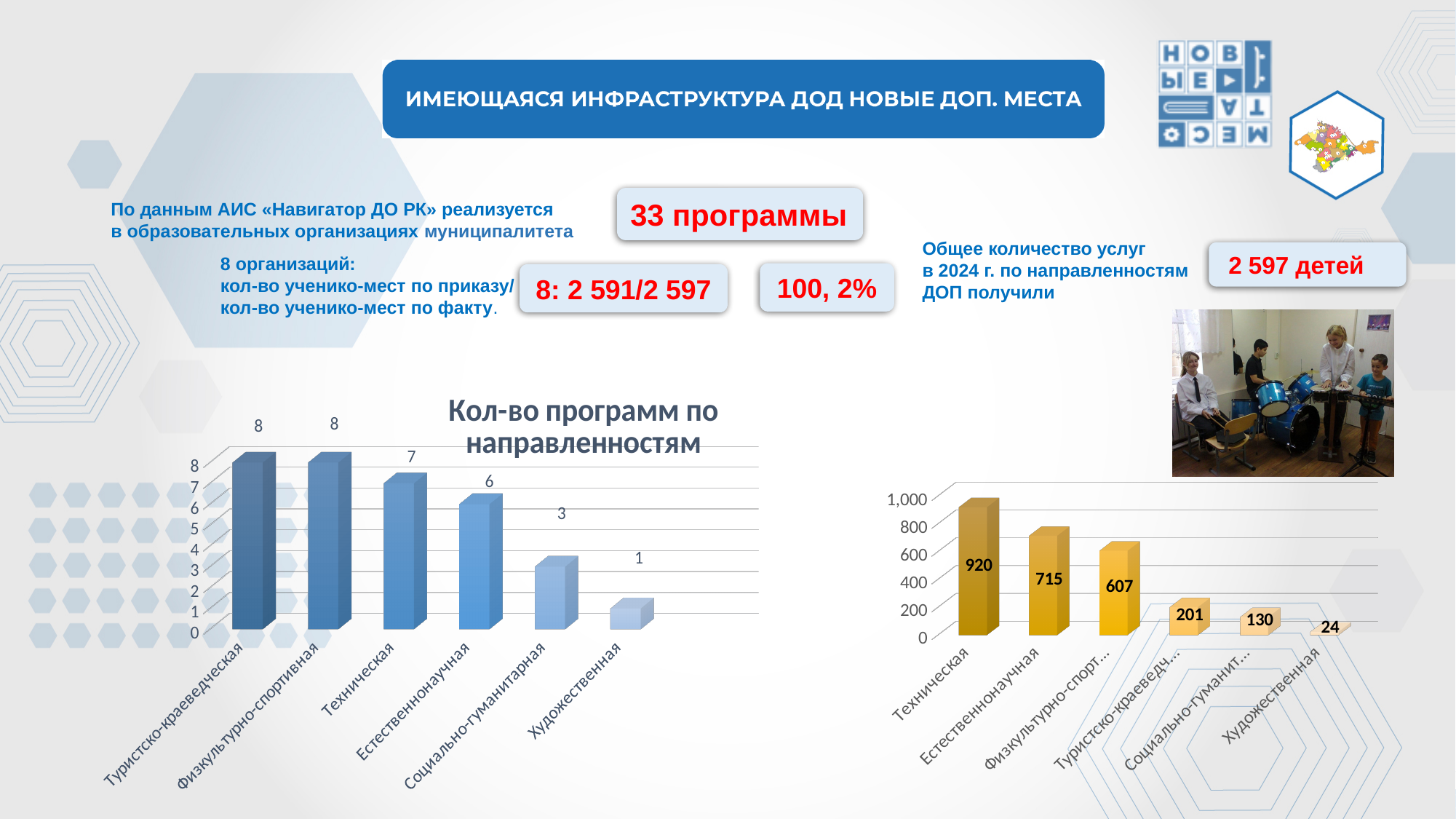
In the chart titled «Кол-во программ по направленностям», do the values rise or fall from left to right? fall In the chart on the right side of the slide, what is the value for Естественнонаучная? 715 What kind of chart is the one on the right side of the slide (with values 920, 715, 607)? bar chart In the chart titled «Кол-во программ по направленностям», what is the difference between Естественнонаучная and Художественная? 5 In the chart on the right side of the slide, which category has the highest value? Техническая In the chart on the right side of the slide, what is the value for Художественная? 24 In the chart on the right side of the slide, what is the difference between Техническая and Естественнонаучная? 205 In the chart on the right side of the slide, which is larger: the value for Физкультурно-спорт… or the value for Туристско-краеведч…? Физкультурно-спорт… In the chart titled «Кол-во программ по направленностям», how many categories are shown? 6 In the chart titled «Кол-во программ по направленностям», which category has the lowest value? Художественная In the chart titled «Кол-во программ по направленностям», how many programs are there for Техническая? 7 In the chart titled «Кол-во программ по направленностям», how many programs are there for Социально-гуманитарная? 3